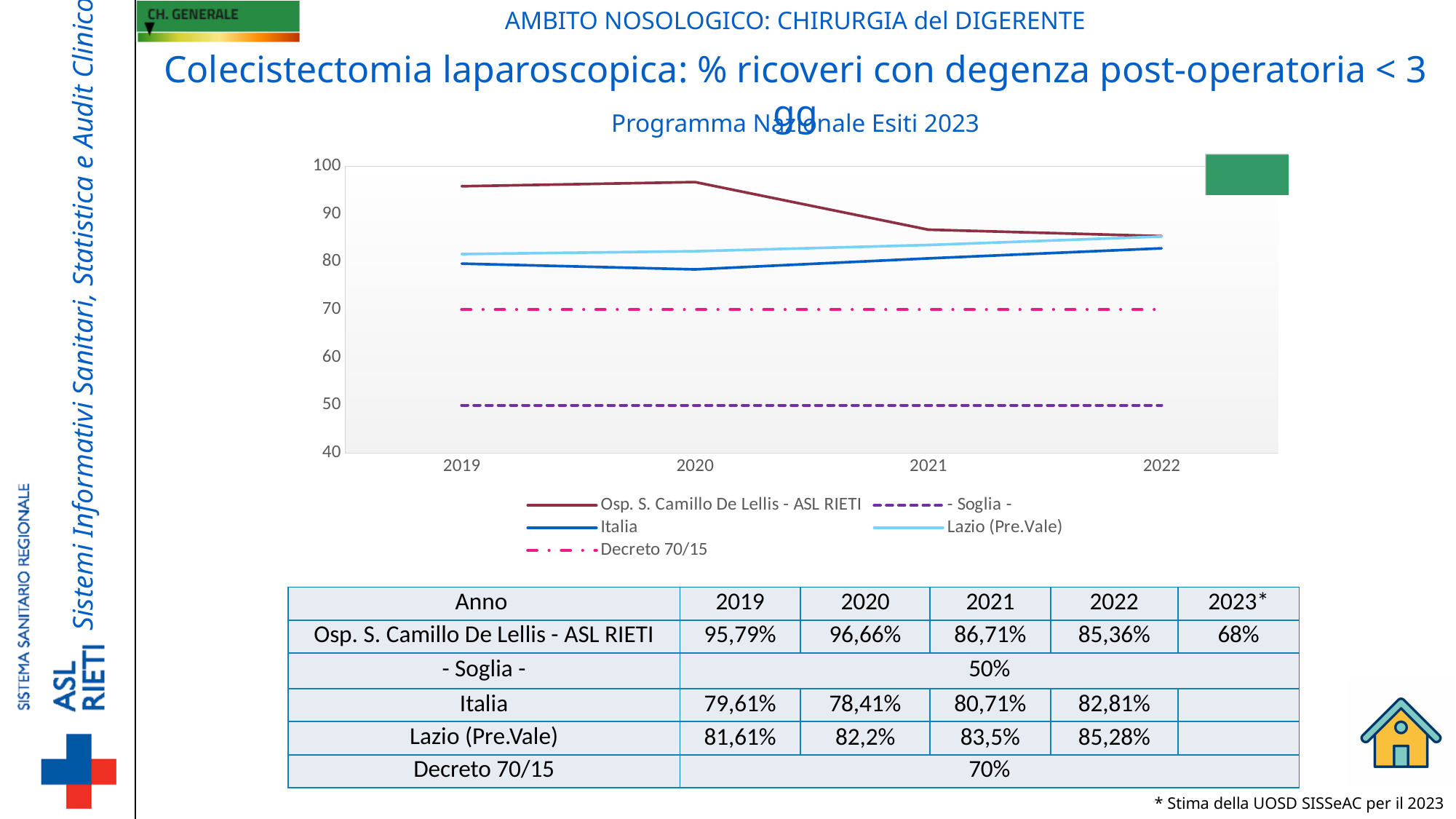
What is the value of the Decreto 70/15 line? 70% In which year is the value for Italia lowest? 2020 What kind of chart is shown on the slide? line chart By how many percentage points did the value for Lazio (Pre.Vale) change from 2019 to 2022? 3,67 What is the value of the - Soglia - line? 50% Does the value for Osp. S. Camillo De Lellis - ASL RIETI rise or fall from 2020 to 2022? fall In which year is the value for Osp. S. Camillo De Lellis - ASL RIETI highest? 2020 What is the value for Osp. S. Camillo De Lellis - ASL RIETI in 2020? 96,66% What is the value for Italia in 2022? 82,81% In 2019, which is larger: Osp. S. Camillo De Lellis - ASL RIETI or Italia? Osp. S. Camillo De Lellis - ASL RIETI How many series does the chart legend list? 5 How many years are plotted along the x axis of the chart? 4